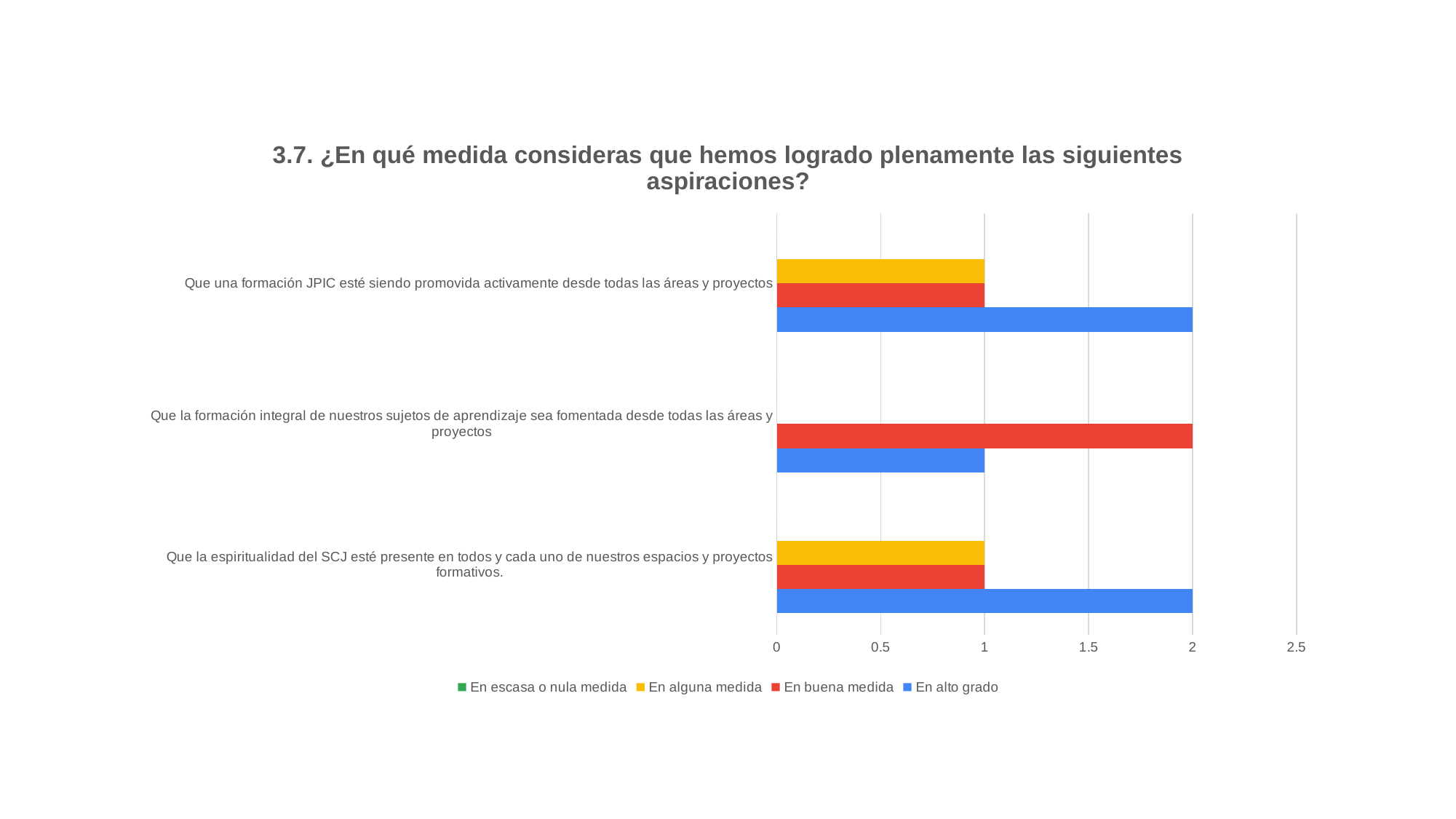
Which series has the highest value for 'Que la formación integral de nuestros sujetos de aprendizaje sea fomentada desde todas las áreas y proyectos'? En buena medida What is the value of 'En alguna medida' for 'Que la espiritualidad del SCJ esté presente en todos y cada uno de nuestros espacios y proyectos formativos.'? 1 What is the value of 'En alto grado' for 'Que una formación JPIC esté siendo promovida activamente desde todas las áreas y proyectos'? 2 What is the value of 'En buena medida' for 'Que la formación integral de nuestros sujetos de aprendizaje sea fomentada desde todas las áreas y proyectos'? 2 How many series does the legend list? 4 What is the difference between 'En buena medida' and 'En alto grado' for 'Que la formación integral de nuestros sujetos de aprendizaje sea fomentada desde todas las áreas y proyectos'? 1 Which series has the highest value for 'Que la espiritualidad del SCJ esté presente en todos y cada uno de nuestros espacios y proyectos formativos.'? En alto grado What colour represents the 'En alto grado' series in the legend? blue What kind of chart is shown on the slide? bar chart What is the value of 'En alto grado' for 'Que la formación integral de nuestros sujetos de aprendizaje sea fomentada desde todas las áreas y proyectos'? 1 For 'Que una formación JPIC esté siendo promovida activamente desde todas las áreas y proyectos', which is larger: 'En alto grado' or 'En buena medida'? En alto grado How many categories (aspirations) are plotted on the chart? 3